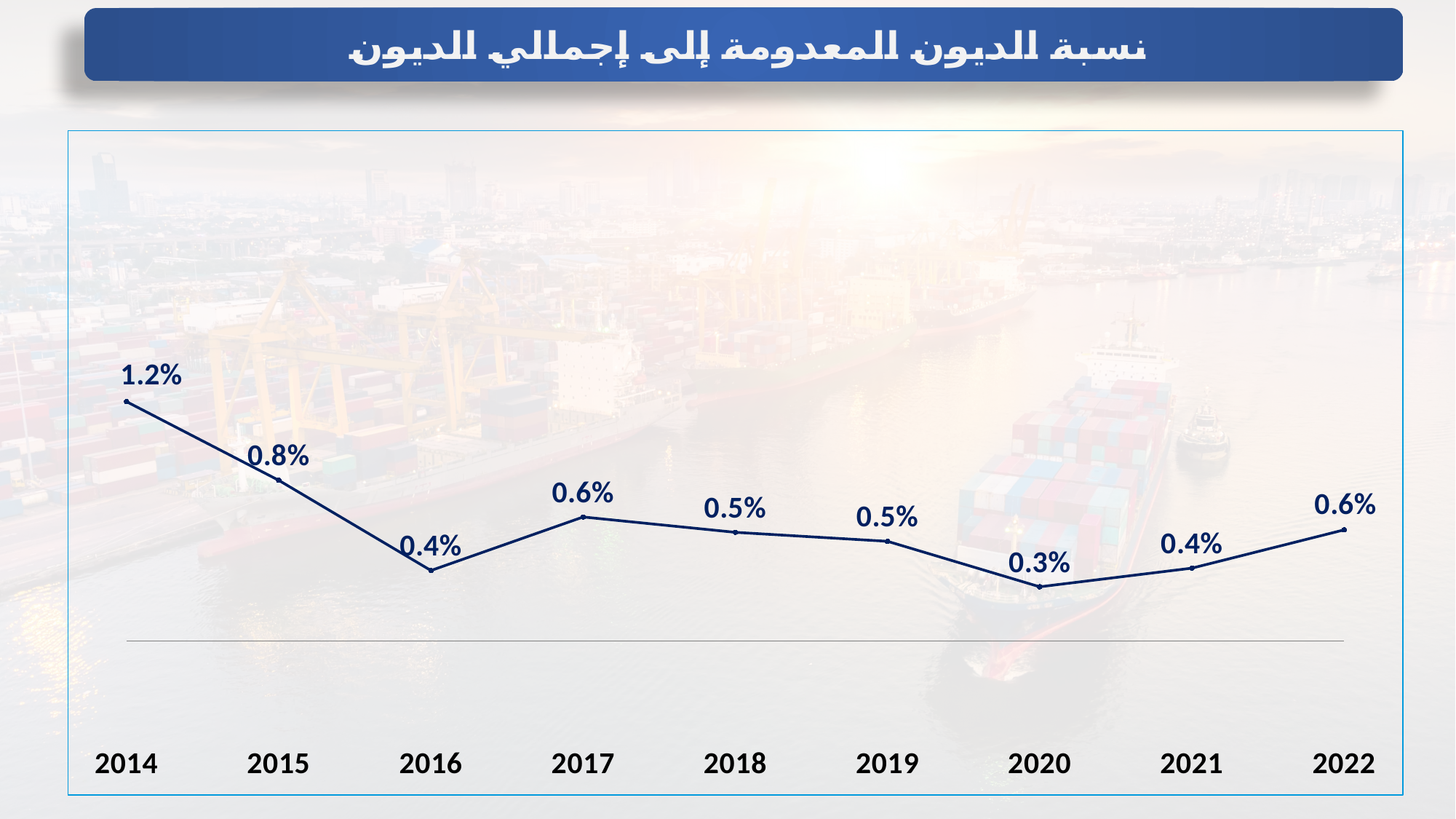
What is the value for 2017? 0.6% Does the value rise or fall from 2014 to 2016? Fall Which year has the lowest value? 2020 What kind of chart is shown on the slide? Line chart Which is larger, the value for 2016 or the value for 2017? 2017 How many years are plotted on the chart? 9 What is the difference between the values for 2014 and 2015? 0.4% What is the value for 2022? 0.6% Which year has the highest value? 2014 What is the value for 2020? 0.3% What is the value for 2014? 1.2% What is the difference between the values for 2022 and 2020? 0.3%